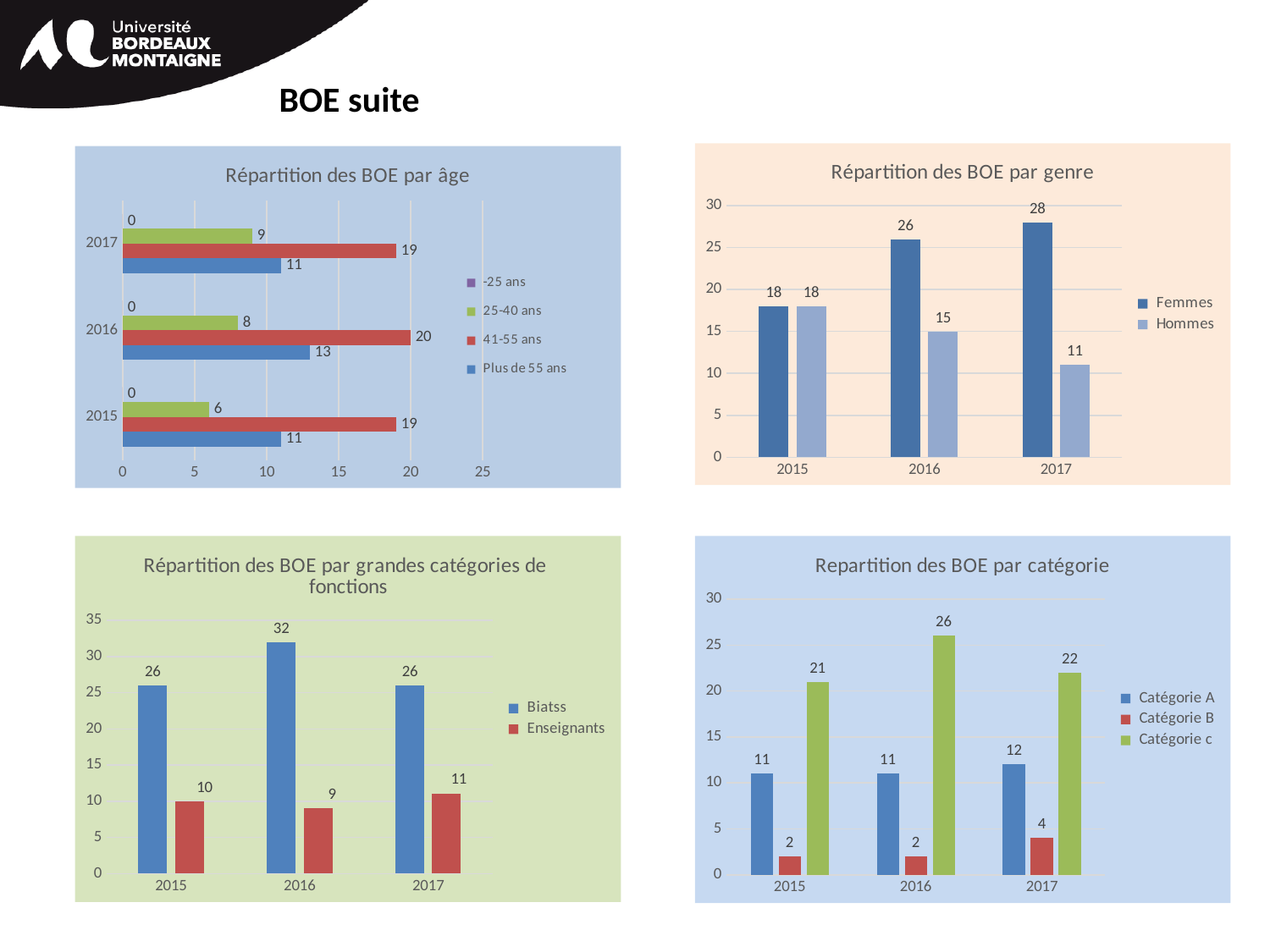
In the chart 'Répartition des BOE par genre', do the Femmes values rise or fall from 2015 to 2017? rise In the chart 'Repartition des BOE par catégorie', what is the value for Catégorie c in 2016? 26 In the chart 'Répartition des BOE par âge', what is the value for '41-55 ans' in 2016? 20 In the chart 'Repartition des BOE par catégorie', how many years are shown on the x axis? 3 What kind of chart is 'Répartition des BOE par grandes catégories de fonctions'? bar chart In the chart 'Répartition des BOE par grandes catégories de fonctions', which year has the highest Biatss value? 2016 In the chart 'Répartition des BOE par genre', what is the difference between Femmes and Hommes in 2016? 11 In the chart 'Répartition des BOE par grandes catégories de fonctions', what is the value for Enseignants in 2016? 9 How many series does the legend of the chart 'Répartition des BOE par âge' list? 4 In the chart 'Répartition des BOE par genre', what is the value for Hommes in 2017? 11 In the chart 'Répartition des BOE par âge', what is the value for '25-40 ans' in 2015? 6 In the chart 'Repartition des BOE par catégorie', which category has the lowest value in 2017? Catégorie B